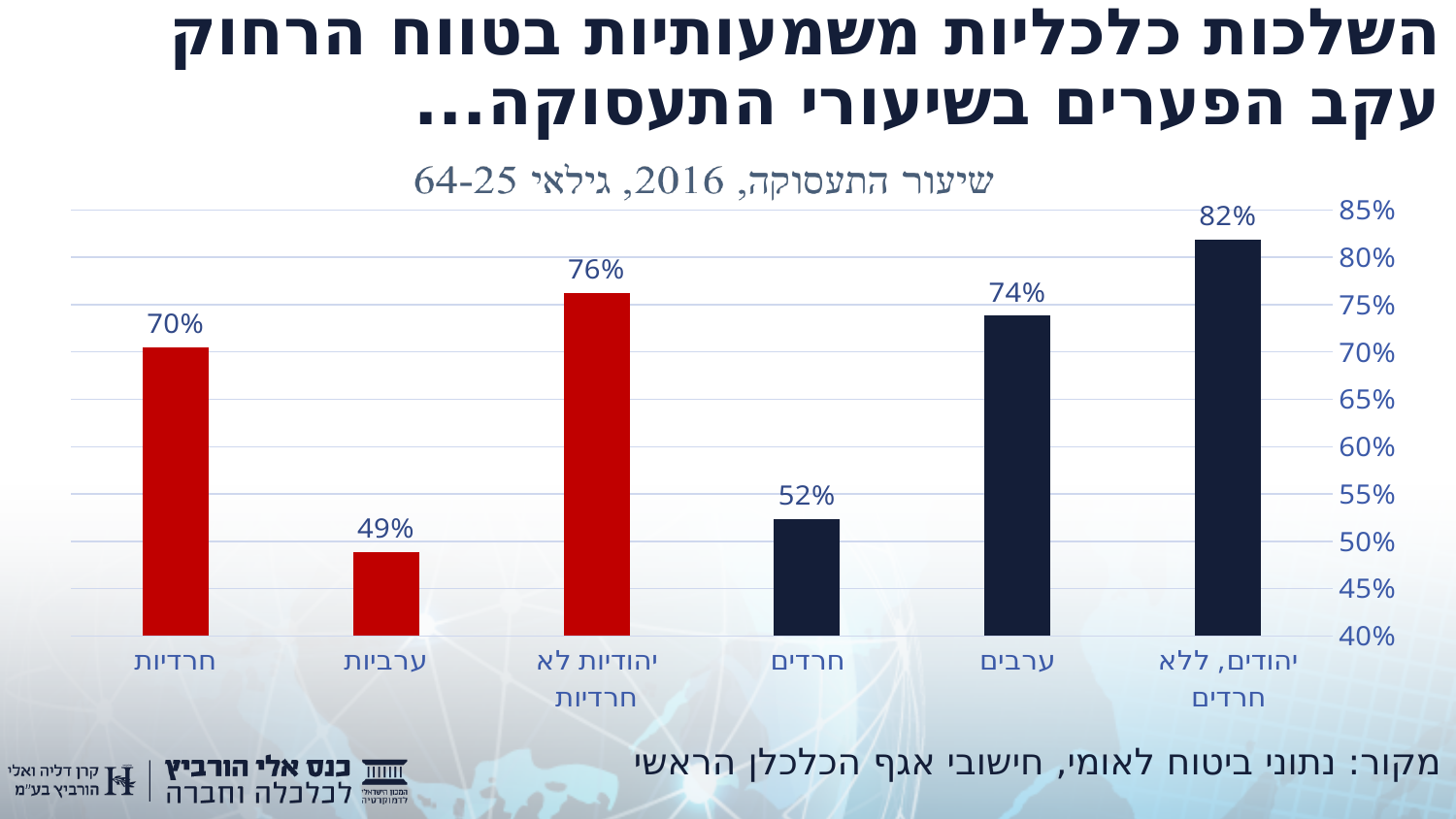
What is the value for חרדיות (Haredi women) in the chart? 70% Which is larger, the value for ערבים (Arab men) or the value for חרדיות (Haredi women)? ערבים What is the value for חרדים (Haredi men)? 52% What is the value for יהודיות לא חרדיות (non-Haredi Jewish women)? 76% Which category has the highest employment rate in the chart? יהודים, ללא חרדים What kind of chart is shown on the slide? Bar chart Which category has the lowest employment rate in the chart? ערביות What is the difference between the values for יהודים, ללא חרדים and חרדים? 30% What is the title of the chart? שיעור התעסוקה, 2016, גילאי 25-64 What is the value for יהודים, ללא חרדים (Jewish men, excluding Haredi)? 82% How many categories are shown in the chart? 6 What is the value for ערביות (Arab women) in the chart? 49%